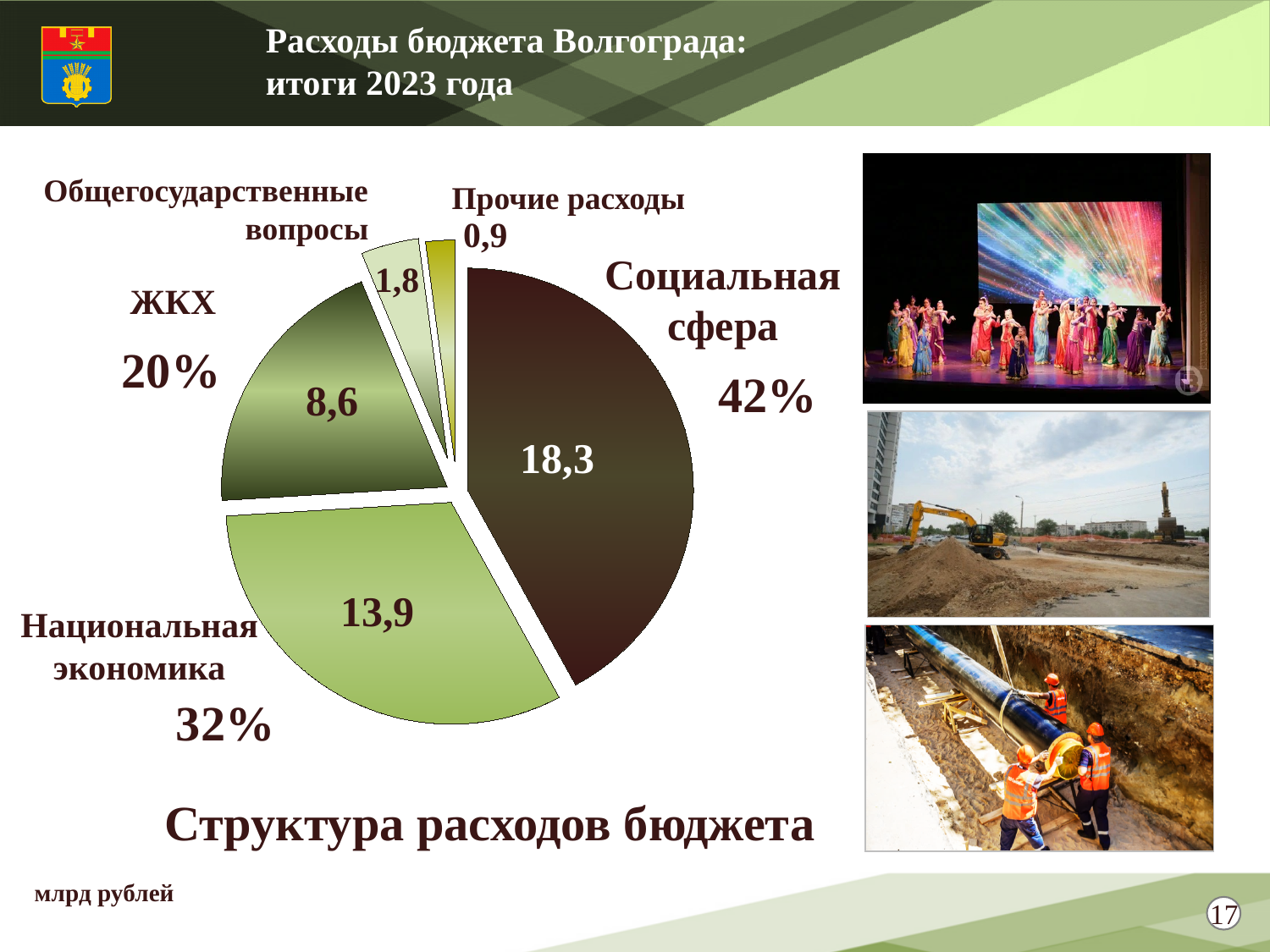
What share of the pie does ЖКХ account for? 20% Which is larger, the value for ЖКХ or the value for Общегосударственные вопросы? ЖКХ What type of chart is shown on the slide? Pie chart What share of the pie does Национальная экономика account for? 32% How many categories are shown in the pie chart? 5 What is the value for Прочие расходы in the pie chart? 0,9 What is the value for Социальная сфера in the pie chart? 18,3 What is the value for Национальная экономика in the pie chart? 13,9 Which category has the smallest slice in the pie chart? Прочие расходы What is the difference between the values for Социальная сфера and Национальная экономика? 4,4 What is the value for ЖКХ in the pie chart? 8,6 Which category has the largest slice in the pie chart? Социальная сфера